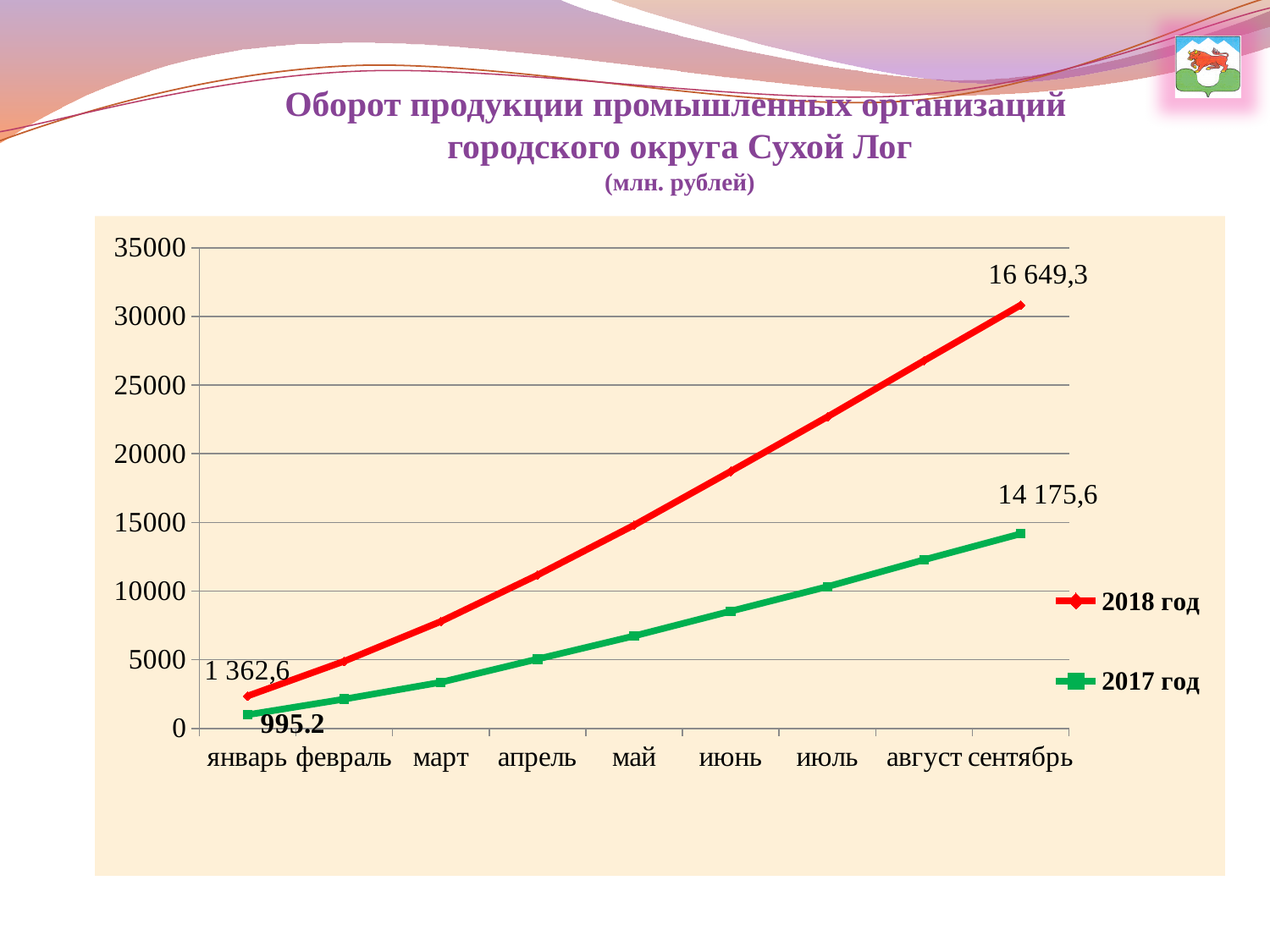
What is the labelled value at the end of the 2018 год line in сентябрь? 16 649,3 How many months are shown along the x axis? 9 Do the values of the 2018 год series rise or fall from январь to сентябрь? rise What colour is the line for the 2017 год series? green What is the labelled value at the end of the 2017 год line in сентябрь? 14 175,6 Is the value for the 2017 год series in май greater or less than 10000? less What is the labelled value for the 2018 год series in январь? 1 362,6 How many series does the legend list? 2 Which series is higher in сентябрь, 2018 год or 2017 год? 2018 год What type of chart is shown on the slide? line chart What is the labelled value for the 2017 год series in январь? 995.2